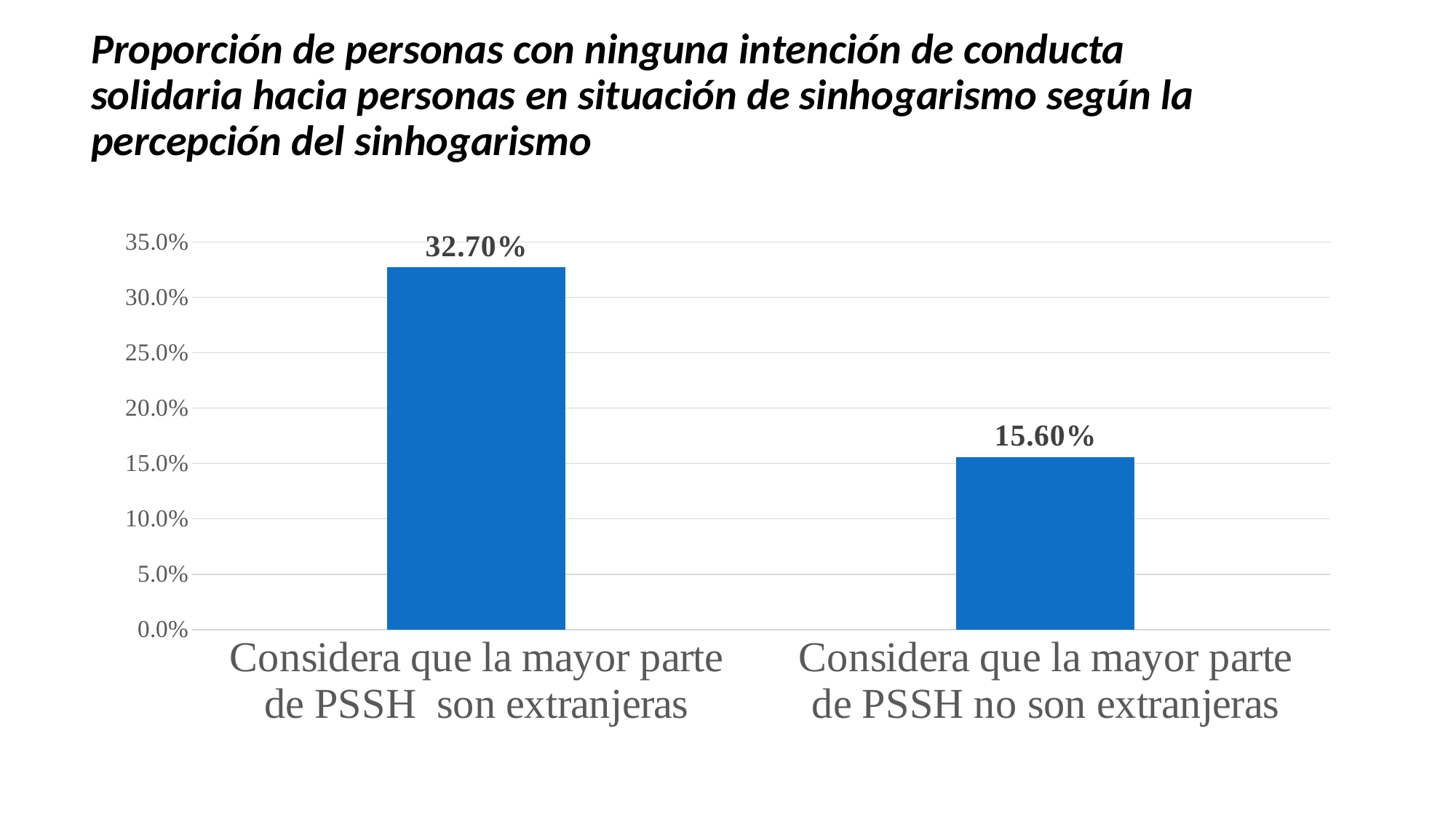
How many categories are shown on the x axis? 2 What is the difference between the value for 'Considera que la mayor parte de PSSH son extranjeras' and the value for 'Considera que la mayor parte de PSSH no son extranjeras'? 17.10% Do the values rise or fall from left to right along the x axis? fall What is the value for 'Considera que la mayor parte de PSSH son extranjeras'? 32.70% What is the value for 'Considera que la mayor parte de PSSH no son extranjeras'? 15.60% Which category has the highest value? Considera que la mayor parte de PSSH son extranjeras Which is larger: the value for 'Considera que la mayor parte de PSSH son extranjeras' or the value for 'Considera que la mayor parte de PSSH no son extranjeras'? Considera que la mayor parte de PSSH son extranjeras What kind of chart is shown on the slide? bar chart Which category has the lowest value? Considera que la mayor parte de PSSH no son extranjeras Is the value for 'Considera que la mayor parte de PSSH son extranjeras' greater or less than 30.0%? greater What is the highest value shown on the y axis? 35.0% Is the value for 'Considera que la mayor parte de PSSH no son extranjeras' greater or less than 20.0%? less